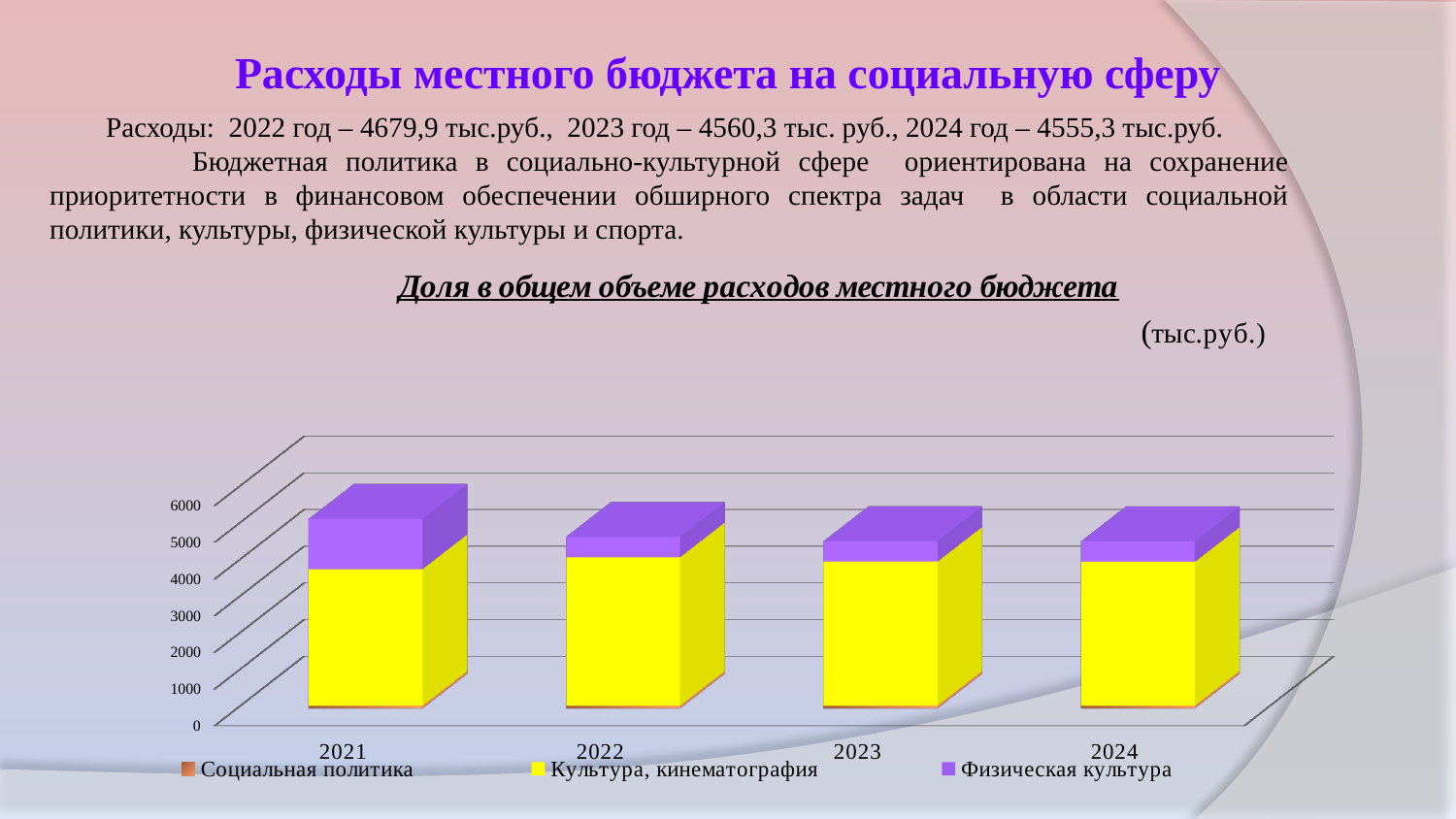
How many years are shown on the x axis of the chart? 4 What colour represents Культура, кинематография in the chart? Yellow How many series does the chart legend list? 3 What kind of chart is shown on the slide? Stacked bar chart Is the total stacked bar for 2022 greater or less than 5000? less Is the total stacked bar for 2021 greater or less than 5000? greater Is the Физическая культура segment for 2021 greater or less than 1000? greater Which year has the tallest stacked bar in the chart? 2021 Which is larger: the total bar for 2021 or the total bar for 2024? 2021 Which year has the largest Физическая культура segment? 2021 What is the title of the chart? Доля в общем объеме расходов местного бюджета Do the total bar heights rise or fall from 2021 to 2024? Fall